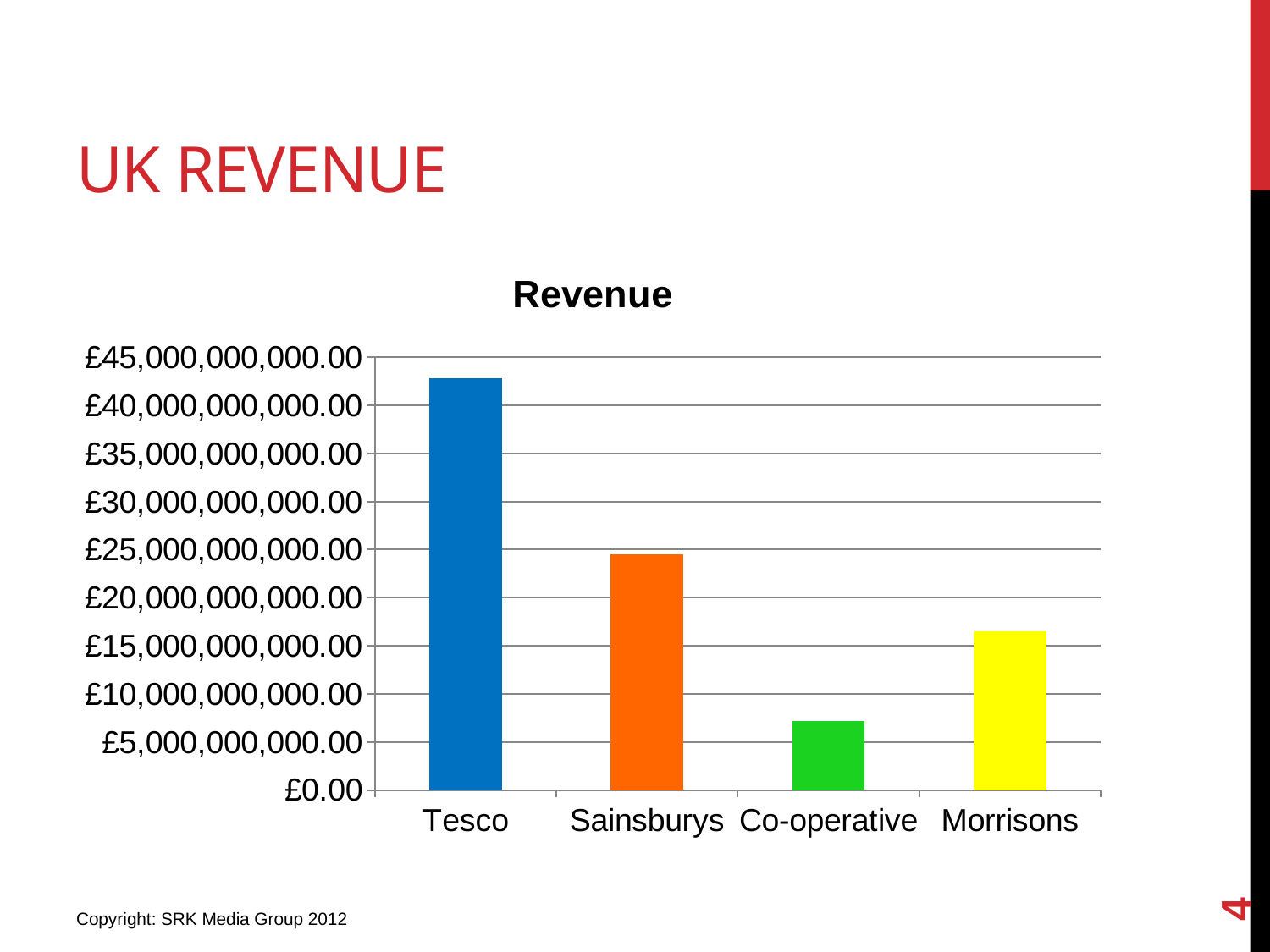
Is the revenue for Tesco greater or less than £40,000,000,000.00? greater Which has the larger revenue, Sainsburys or Morrisons? Sainsburys Is the revenue for Co-operative greater or less than £10,000,000,000.00? less Is the revenue for Sainsburys greater or less than £20,000,000,000.00? greater What kind of chart is shown on the slide? Bar chart Which has the larger revenue, Co-operative or Morrisons? Morrisons Which company has the lowest revenue on the chart? Co-operative What colour is the bar for Sainsburys? Orange How many companies are shown on the chart? 4 Which company has the highest revenue on the chart? Tesco What is the title of the chart? Revenue